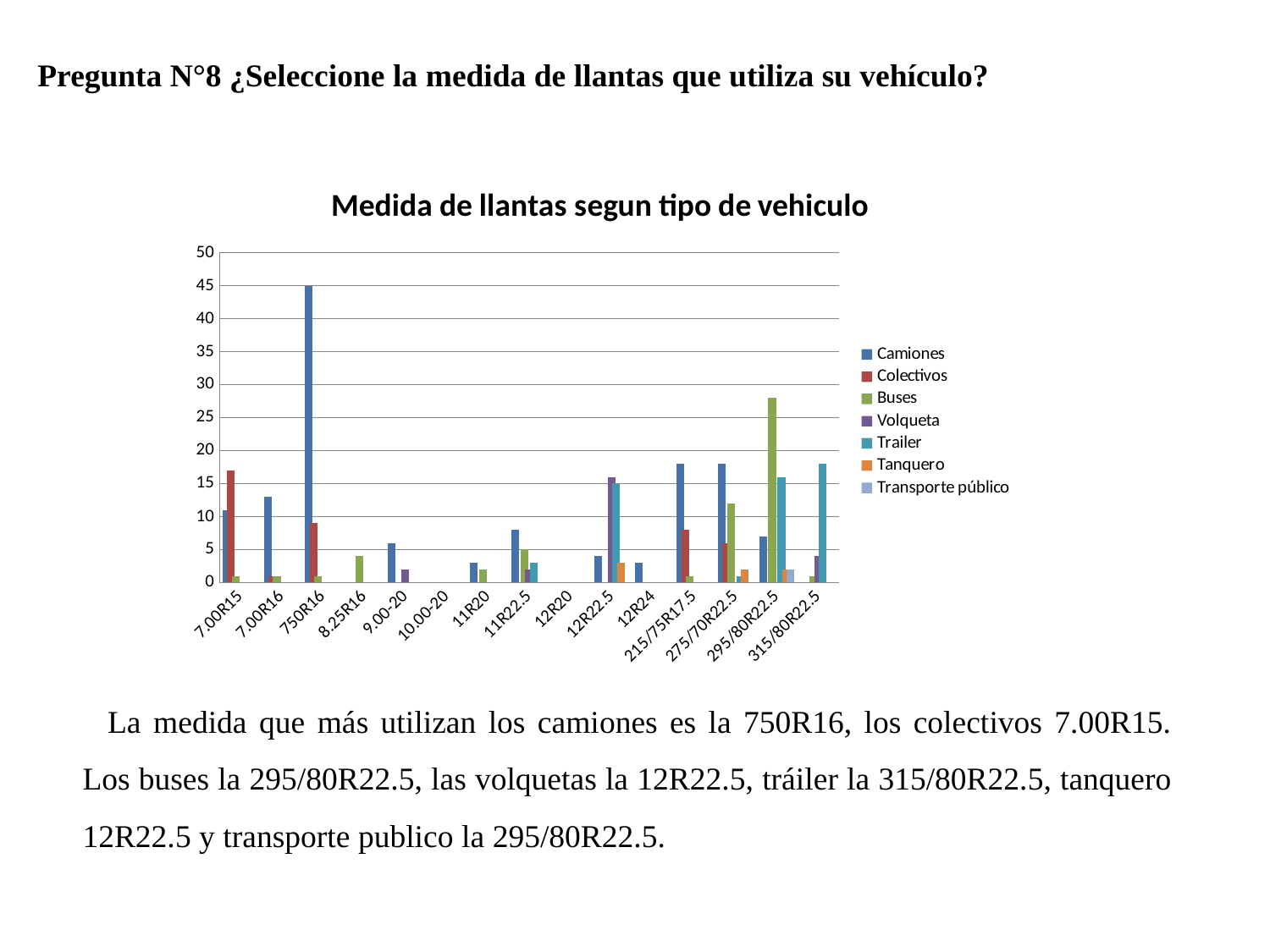
For which tire size is the Colectivos value highest? 7.00R15 How many tire-size categories are shown on the x axis? 15 What kind of chart is shown on the slide? bar chart How many series does the legend list? 7 For which tire size is the Buses value highest? 295/80R22.5 For which tire size is the Camiones value highest? 750R16 What is the title of the chart? Medida de llantas segun tipo de vehiculo Which series is shown in green in the legend? Buses Is the Buses value for 295/80R22.5 greater or less than 25? greater Is the Camiones value for 750R16 greater or less than 40? greater Which is larger: the Camiones value for 750R16 or the Buses value for 295/80R22.5? Camiones value for 750R16 Is the Camiones value for 7.00R16 greater or less than 10? greater